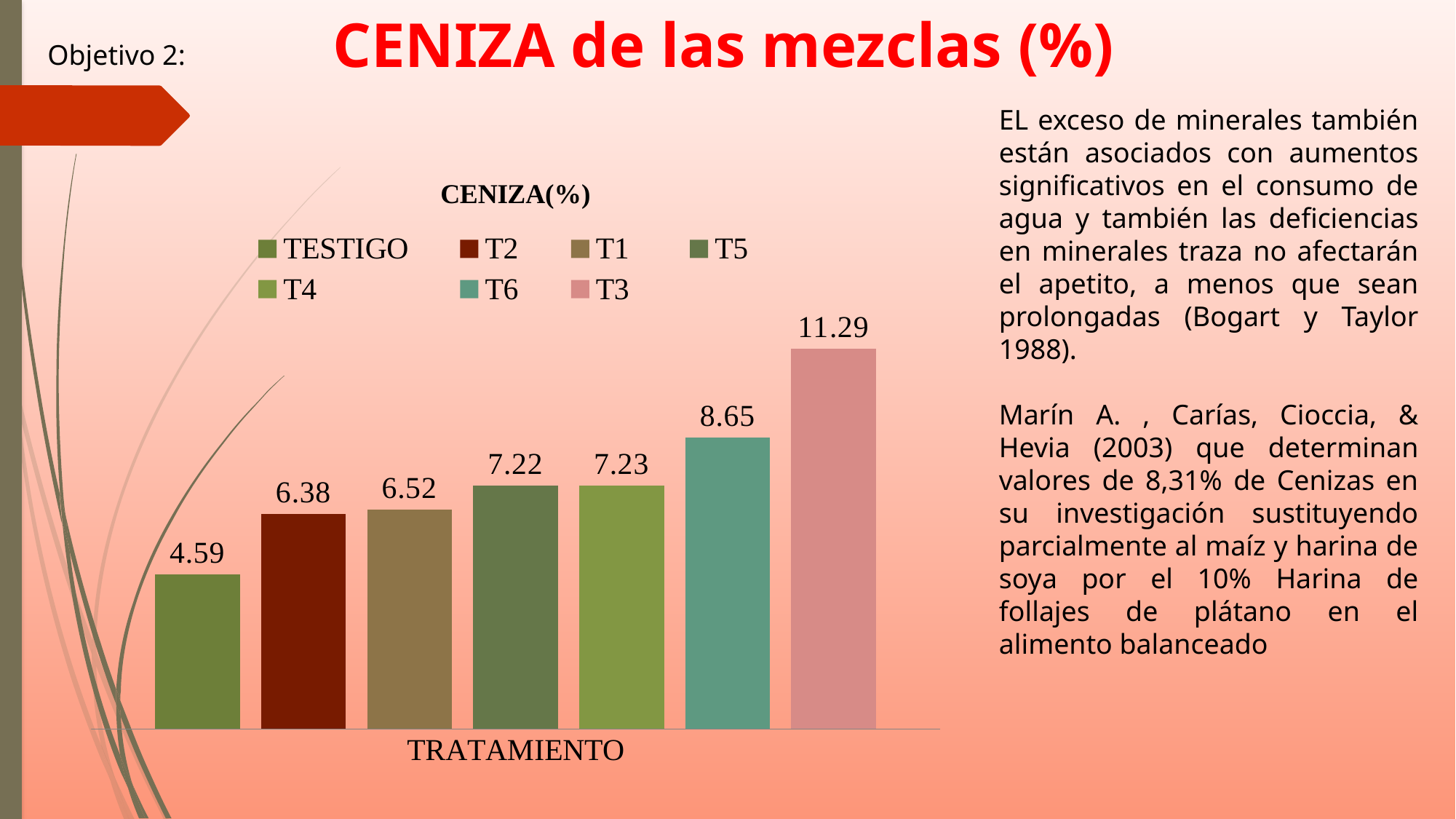
Which treatment has the lowest ceniza value? TESTIGO What is the value for T2? 6.38 What is the value for T6? 8.65 What is the value for TESTIGO? 4.59 What is the difference between the values for T3 and TESTIGO? 6.70 Which is larger, the value for T6 or the value for T1? T6 How many bars are shown in the chart? 7 Which treatment has the highest ceniza value? T3 What kind of chart is shown on the slide? Bar chart What is the title of the chart? CENIZA(%) How many entries does the legend list? 7 What is the value for T3? 11.29